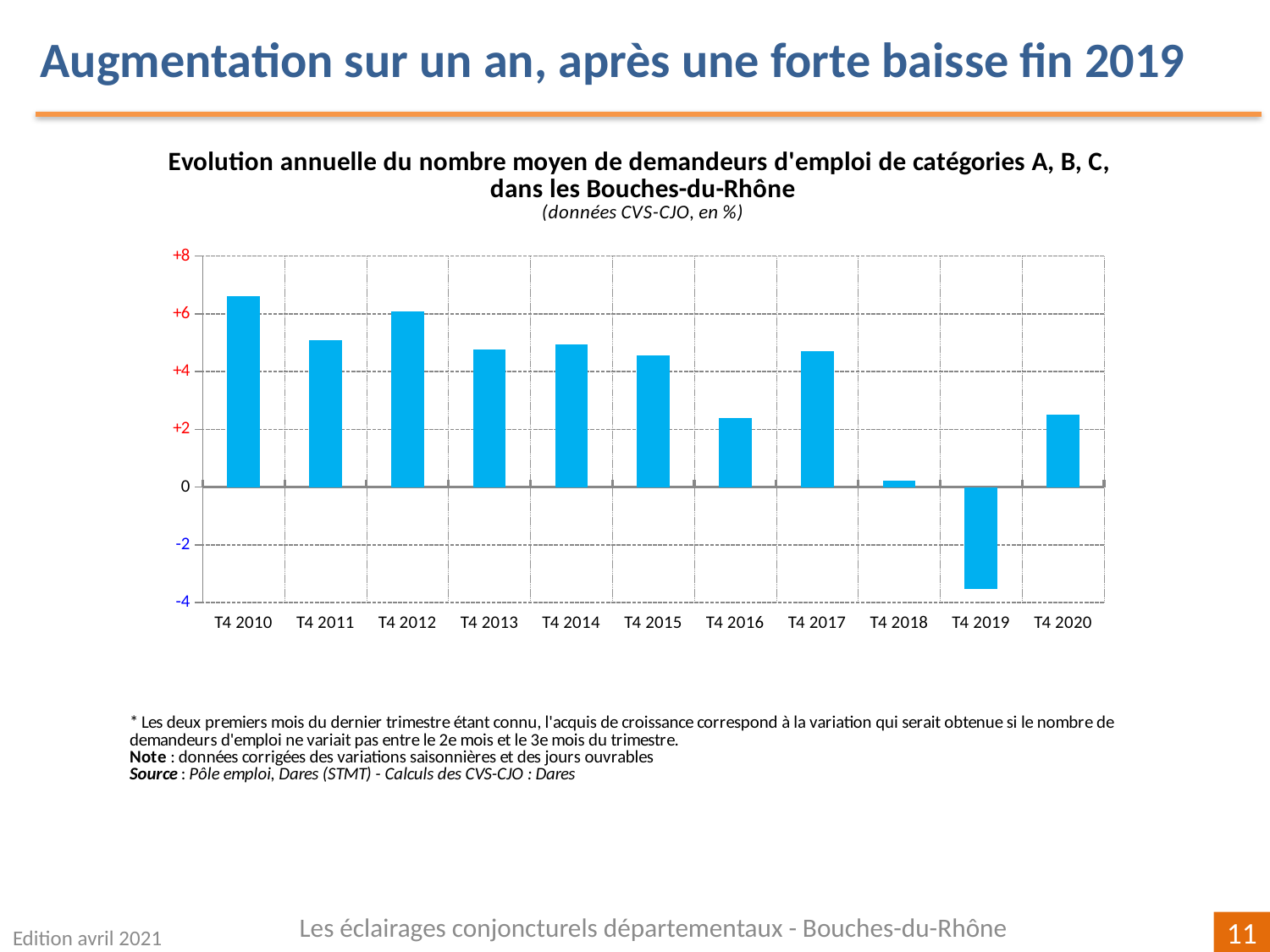
Is the value for T4 2019 greater or less than -2? less In what unit are the chart's data expressed, according to the subtitle? % Is the value for T4 2016 greater or less than +4? less Is the value for T4 2010 greater or less than +6? greater Which is larger, the value for T4 2018 or the value for T4 2020? T4 2020 Which quarter has the lowest value? T4 2019 How many quarters (categories) are plotted on the x axis? 11 How many quarters show a negative value? 1 What kind of chart is shown on the slide? bar chart Which quarter has the highest value? T4 2010 Which is larger, the value for T4 2012 or the value for T4 2016? T4 2012